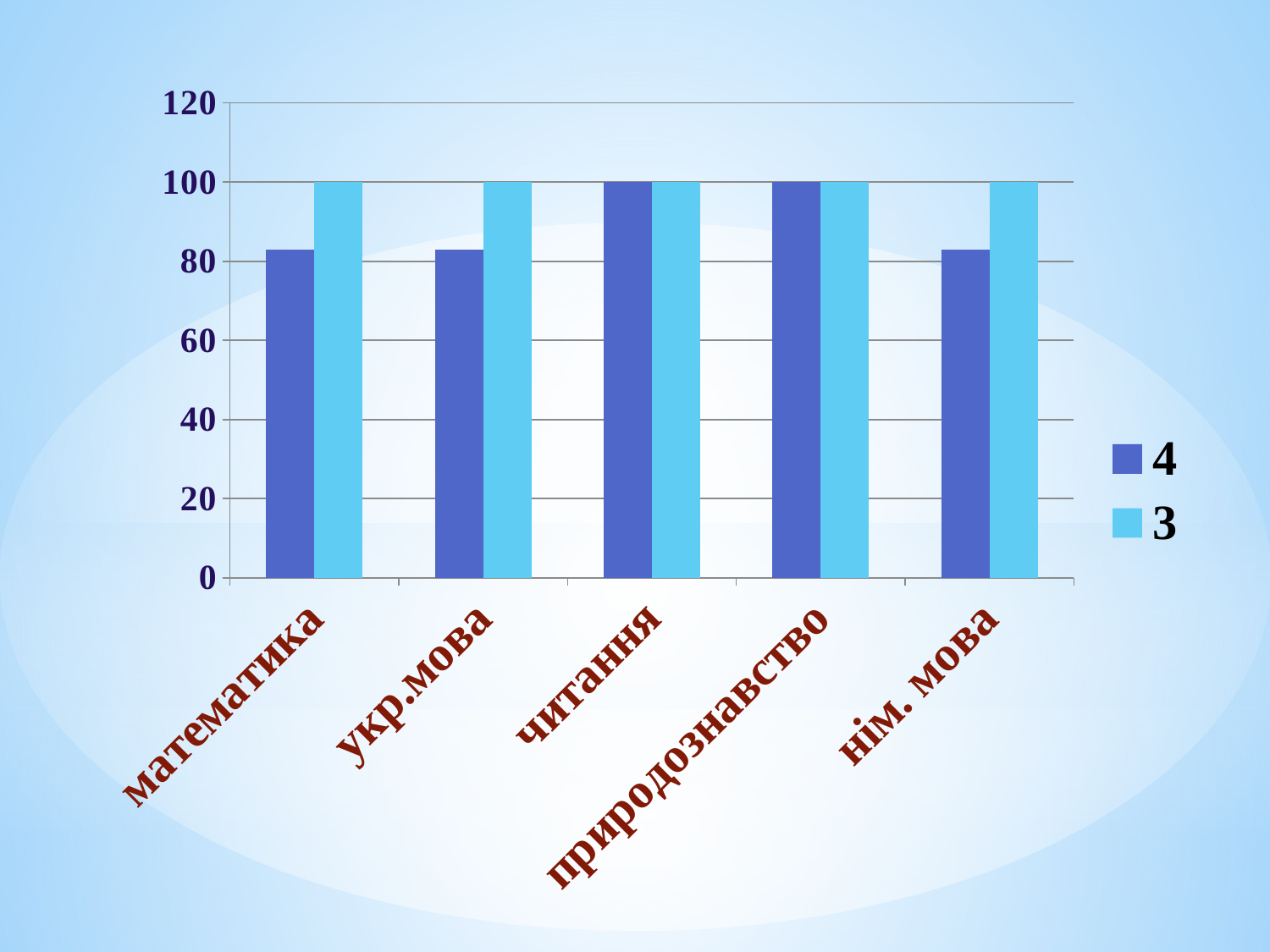
What are the series names listed in the legend? 4 and 3 How many series does the legend list? 2 What is the value of series 3 for математика? 100 Is the value of series 4 for нім. мова greater or less than 80? greater Is the value of series 4 for математика greater or less than 100? less What is the value of series 4 for природознавство? 100 Which is larger for series 4: математика or читання? читання Which is larger for укр.мова: series 4 or series 3? series 3 What kind of chart is shown on the slide? bar chart How many categories are shown on the x axis of the chart? 5 What colour are the bars for series 3? light blue What is the value of series 4 for читання? 100